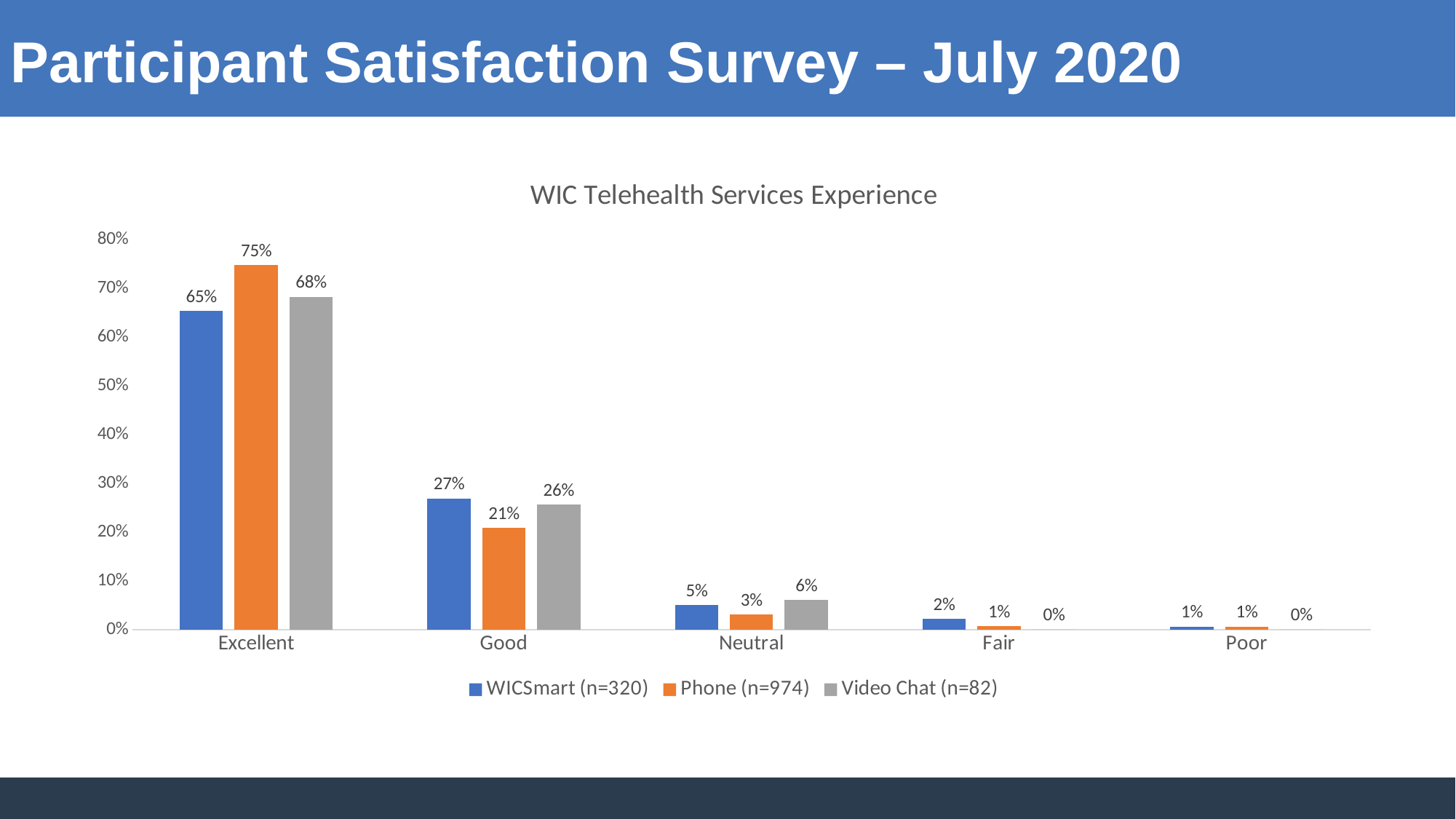
What kind of chart is shown on the slide? Bar chart Which series has the lowest value in the Good category? Phone (n=974) What is the title of the chart? WIC Telehealth Services Experience How many series does the legend list? 3 Which is larger for Neutral: the Video Chat value or the Phone value? Video Chat Is the WICSmart value for Excellent greater or less than 60%? greater How many rating categories are shown on the x axis? 5 What is the value for Video Chat in the Good category? 26% What is the difference between the Phone and WICSmart values for Excellent? 10% What percentage of Phone respondents rated their experience as Excellent? 75% What percentage of WICSmart respondents rated their experience as Neutral? 5% Which series has the highest value in the Excellent category? Phone (n=974)